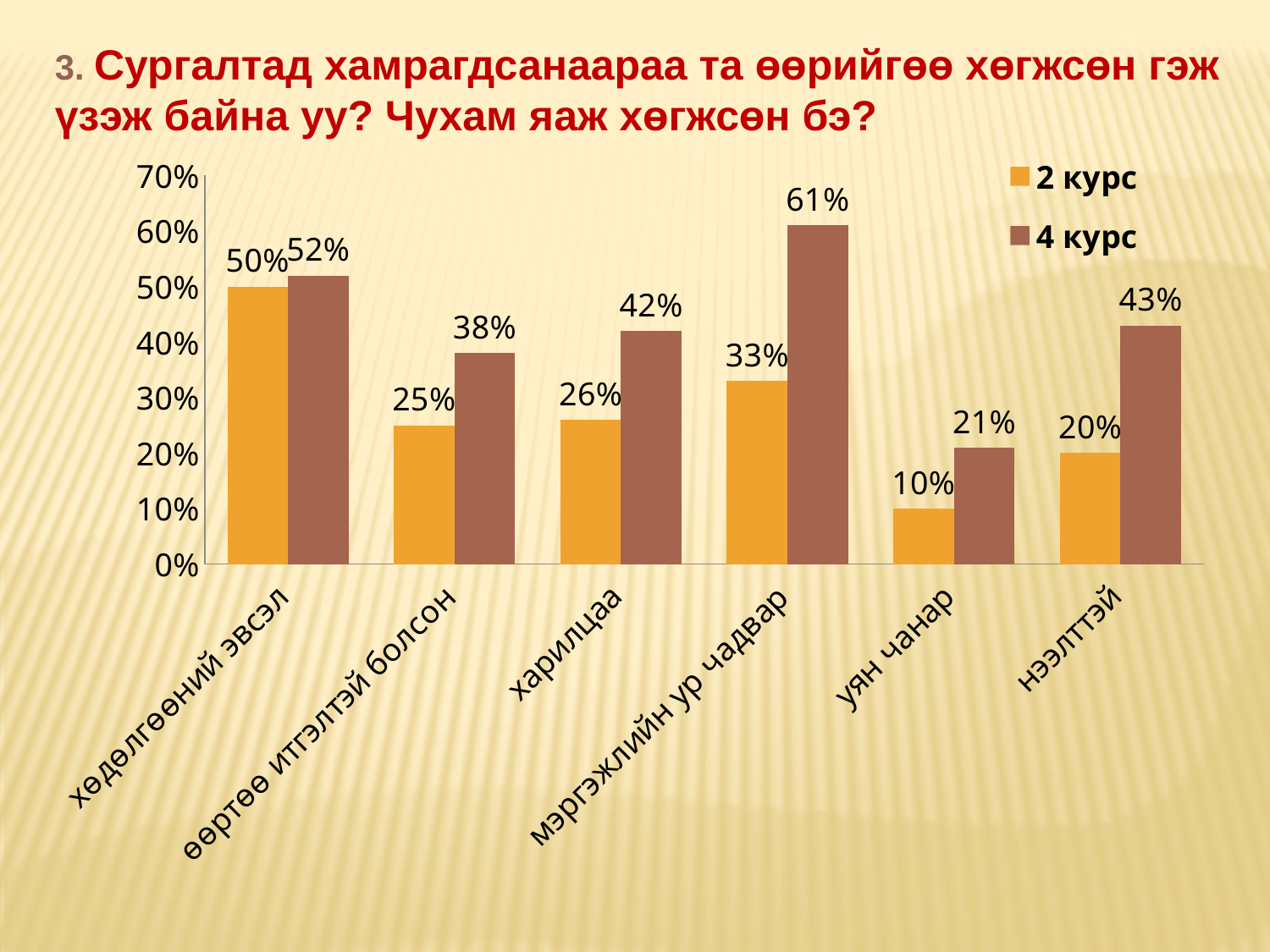
What is the value for "4 курс" in the "нээлттэй" category? 43% What kind of chart is shown on the slide? bar chart What is the difference between the "4 курс" and "2 курс" values in the "мэргэжлийн ур чадвар" category? 28% How many series does the legend list? 2 Which category has the highest value for "4 курс"? мэргэжлийн ур чадвар What is the value for "2 курс" in the "уян чанар" category? 10% What is the value for "2 курс" in the "хөдөлгөөний эвсэл" category? 50% Which is larger in the "харилцаа" category: the "2 курс" value or the "4 курс" value? 4 курс Which category has the lowest value for "2 курс"? уян чанар How many categories are shown on the x axis? 6 Which series is shown in orange? 2 курс What is the value for "4 курс" in the "мэргэжлийн ур чадвар" category? 61%